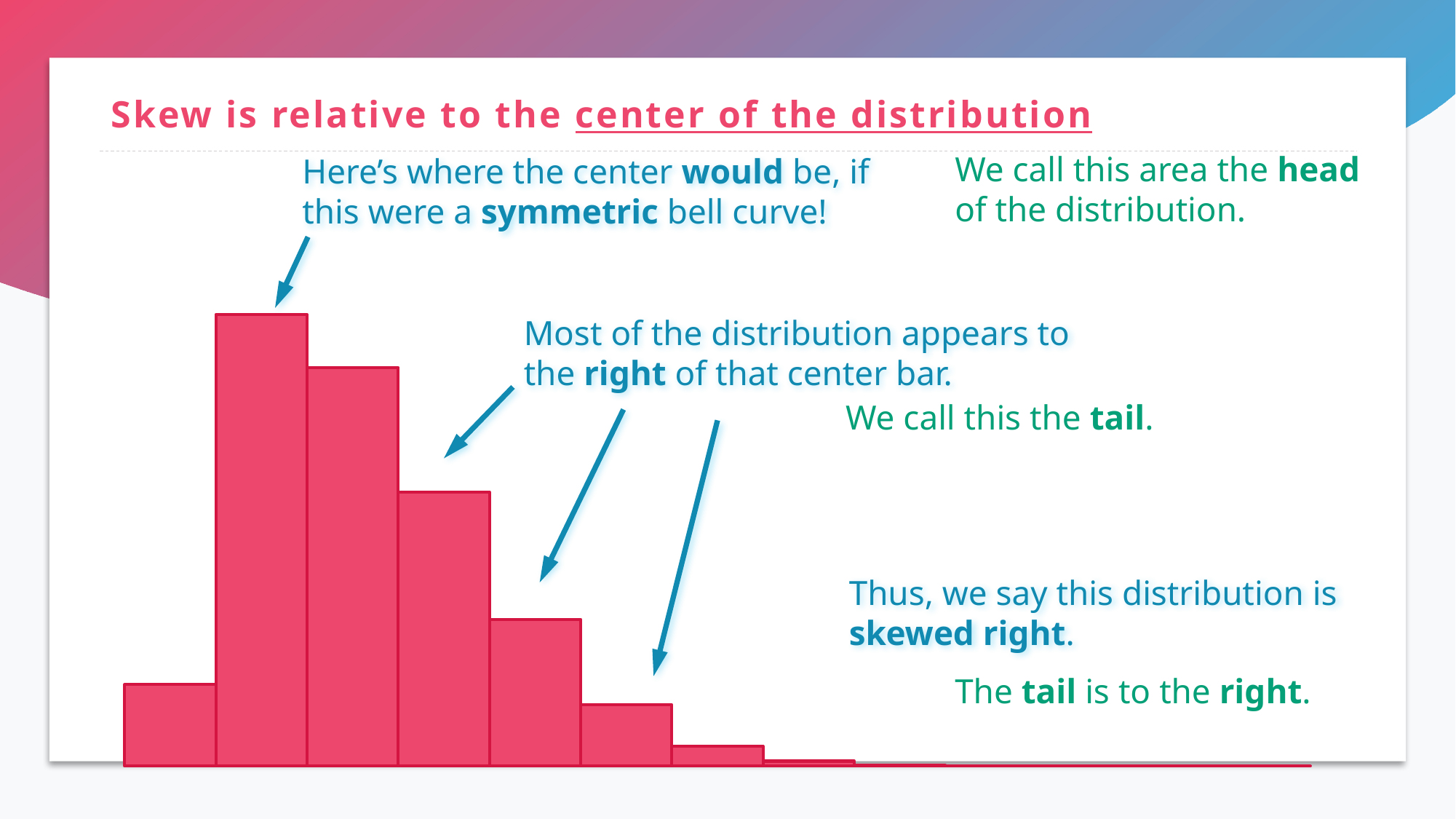
Is the third bar from the left taller or shorter than the fourth bar from the left? taller Which bar in the chart is the tallest? the second bar from the left What is the title of the slide containing the chart? Skew is relative to the center of the distribution What kind of chart is shown on the slide? bar chart According to the slide, in which direction is this distribution skewed? right Is the second bar from the left taller or shorter than the first bar on the left? taller Starting from the tallest bar, do the bar heights rise or fall moving to the right? fall What colour are the bars in the chart? red